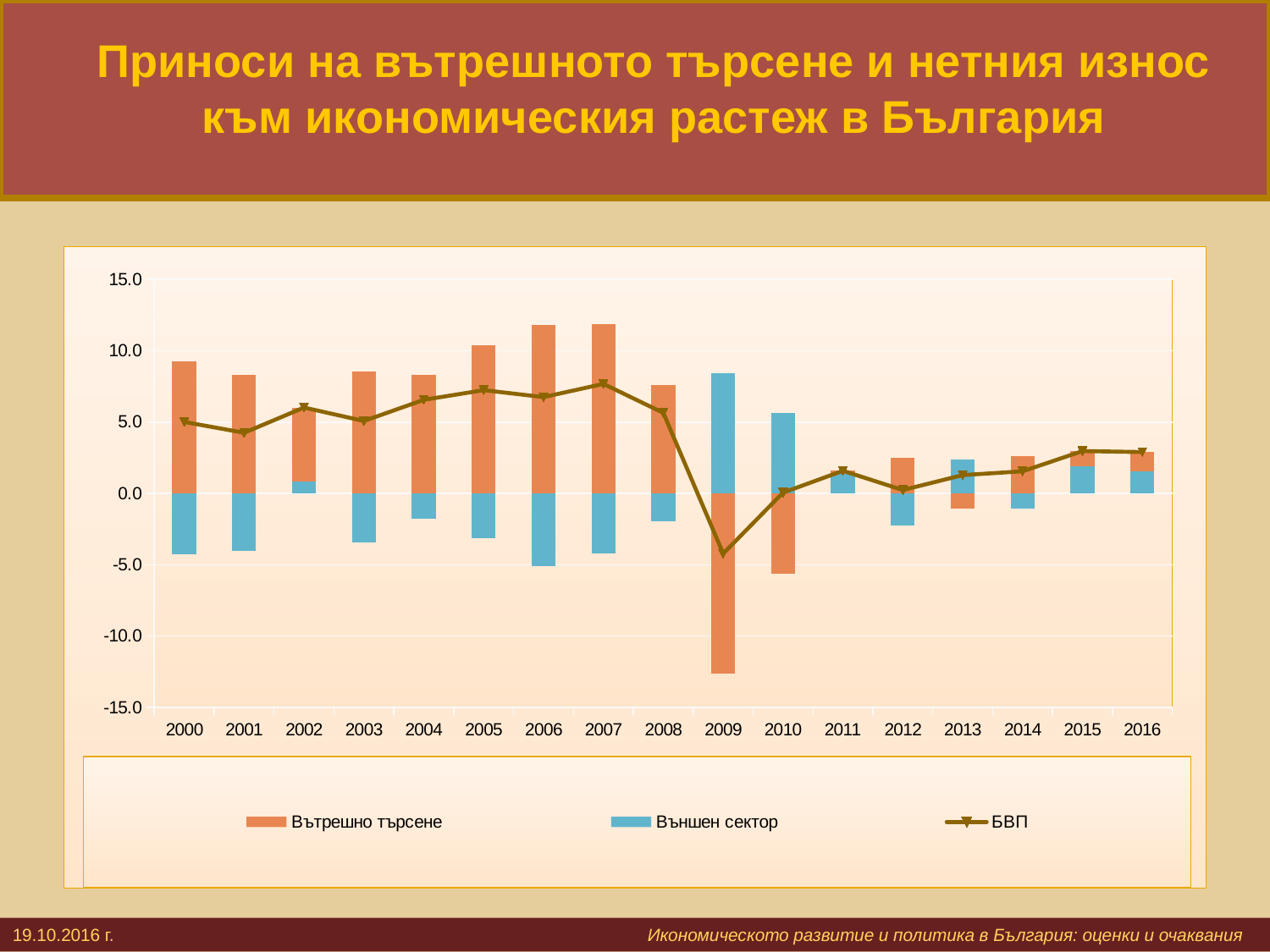
What kind of chart is shown on the slide? A combined bar and line chart Which year has the larger Вътрешно търсене value, 2004 or 2005? 2005 How many years are shown on the x axis of the chart? 17 How many series does the chart legend list? 3 Is the БВП value for 2009 greater or less than 0.0? less In which year is the Външен сектор bar the highest? 2009 Which series is drawn as a line in the chart? БВП Is the value of Вътрешно търсене for 2009 greater or less than -10.0? less Does the БВП line rise or fall from 2009 to 2015? rise In which year is the БВП line at its lowest? 2009 Is the value of Вътрешно търсене for 2007 greater or less than 10.0? greater In which year is the Вътрешно търсене bar at its lowest (most negative)? 2009